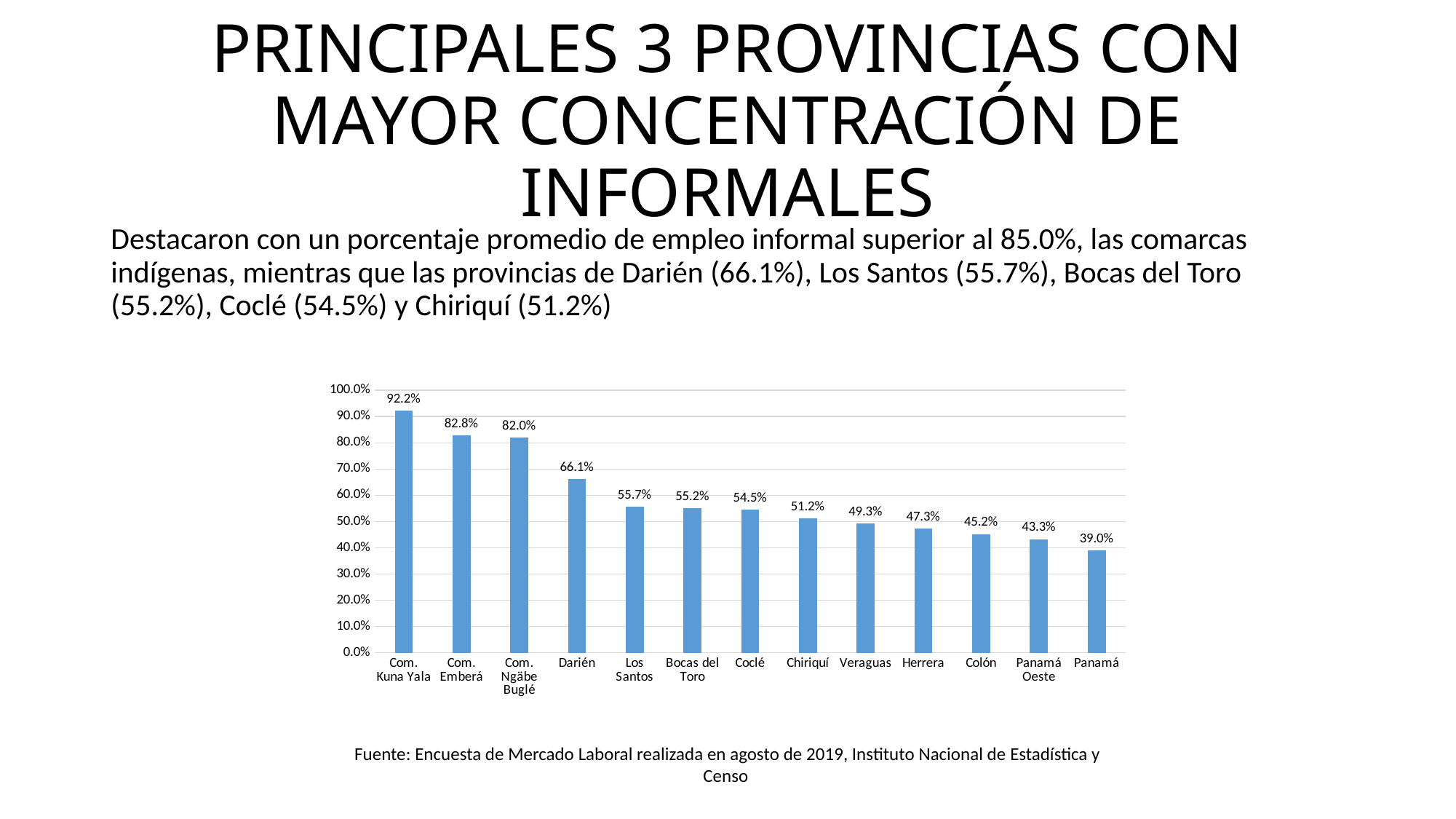
What is the value for Veraguas? 49.3% What is the difference between the values for Com. Kuna Yala and Panamá? 53.2% What is the value for Darién? 66.1% Which category has the highest value? Com. Kuna Yala Which category has the lowest value? Panamá Which is larger, the value for Coclé or the value for Herrera? Coclé What is the value for Panamá Oeste? 43.3% Is the value for Colón greater or less than 50.0%? less What is the difference between the values for Com. Emberá and Com. Ngäbe Buglé? 0.8% How many categories are shown on the x axis? 13 Do the values rise or fall from left to right along the x axis? fall What kind of chart is shown on the slide? bar chart